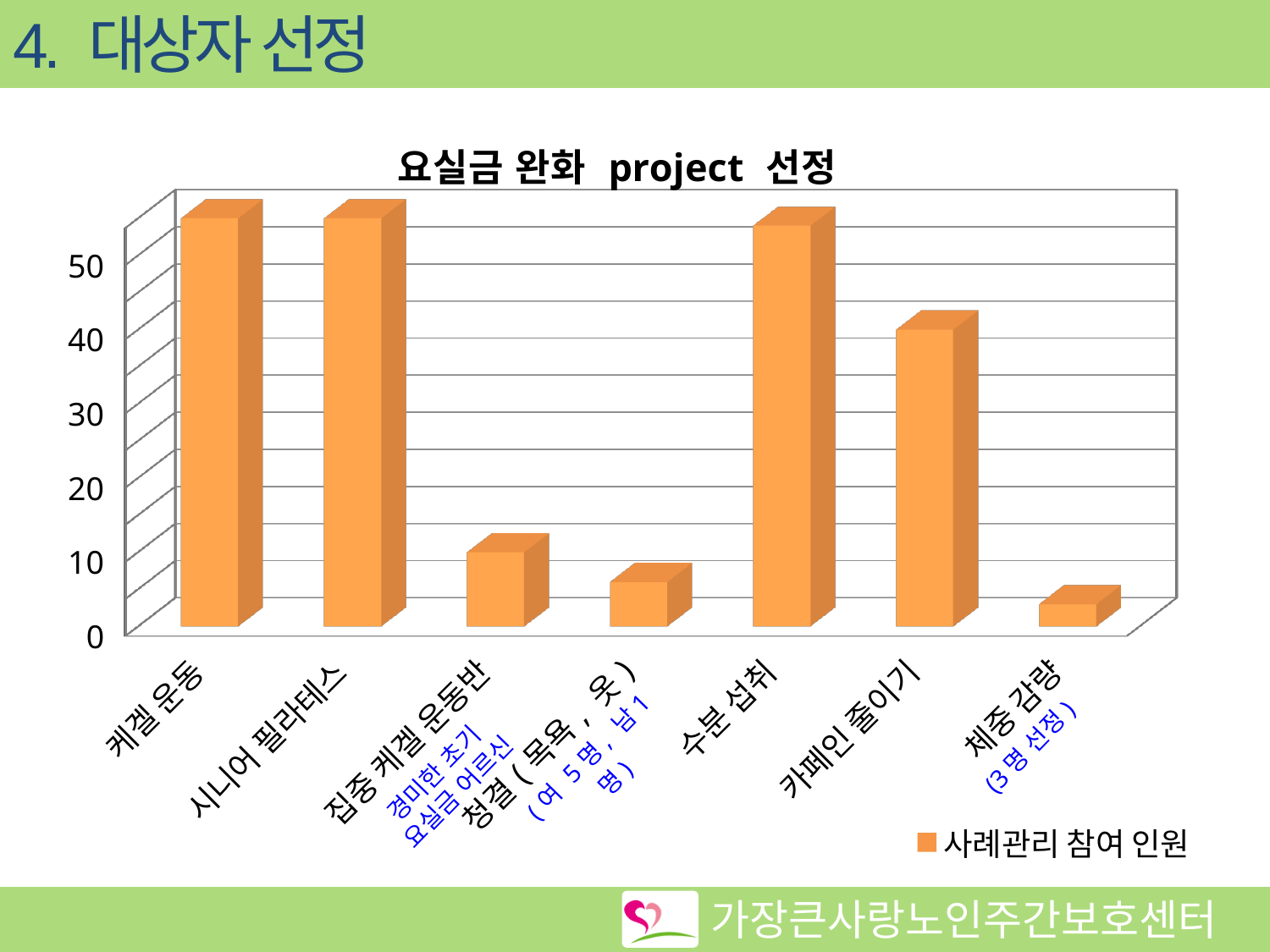
Is the value for 체중 감량 greater or less than 10? less Is the value for 수분 섭취 greater or less than 40? greater Is the value for 카페인 줄이기 greater or less than 30? greater How many categories are plotted on the x axis? 7 What kind of chart is shown on the slide? Bar chart What is the title of the chart? 요실금 완화 project 선정 How many series does the legend list? 1 Which is larger, the value for 시니어 필라테스 or the value for 카페인 줄이기? 시니어 필라테스 What series does the legend list? 사례관리 참여 인원 Which is larger, the value for 카페인 줄이기 or the value for 집중 케겔 운동반? 카페인 줄이기 Which category has the lowest value? 체중 감량